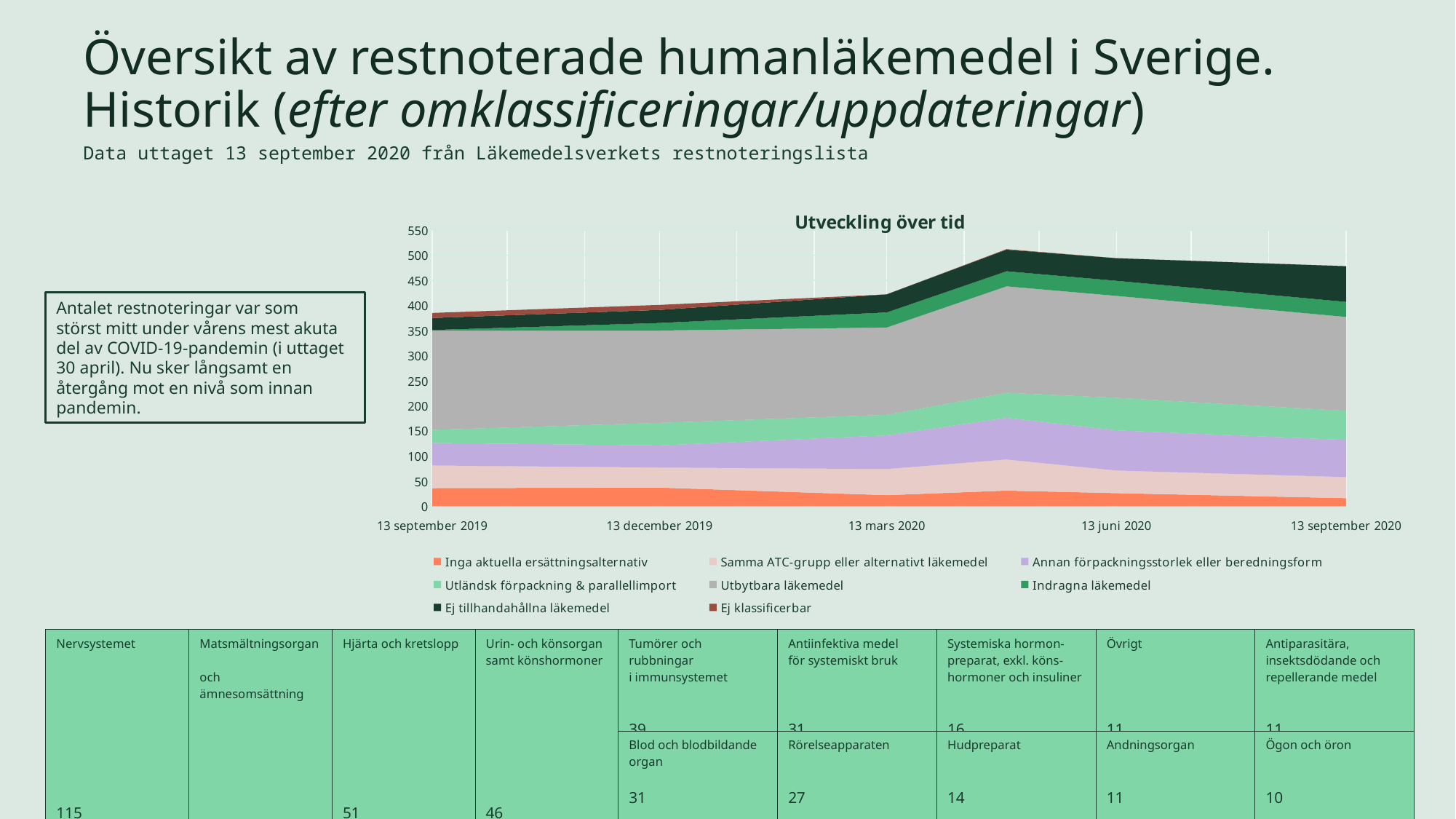
Does the stacked total in "Utveckling över tid" rise or fall between 13 juni 2020 and 13 september 2020? fall At which date is the stacked total in "Utveckling över tid" lowest? 13 september 2019 Does the stacked total in "Utveckling över tid" rise or fall between 13 september 2019 and 13 juni 2020? rise How many dates are labelled on the x axis of the "Utveckling över tid" chart? 5 Which series is shown in orange at the bottom of the stack in "Utveckling över tid"? Inga aktuella ersättningsalternativ How many series does the legend of the "Utveckling över tid" chart list? 8 What kind of chart is "Utveckling över tid"? Stacked area chart Is the stacked total at 13 september 2019 in "Utveckling över tid" greater or less than 400? less Is the stacked total at 13 september 2020 in "Utveckling över tid" greater or less than 500? less At which date does the stacked total in "Utveckling över tid" reach its highest point? 30 april 2020 What is the title of the chart on the slide? Utveckling över tid